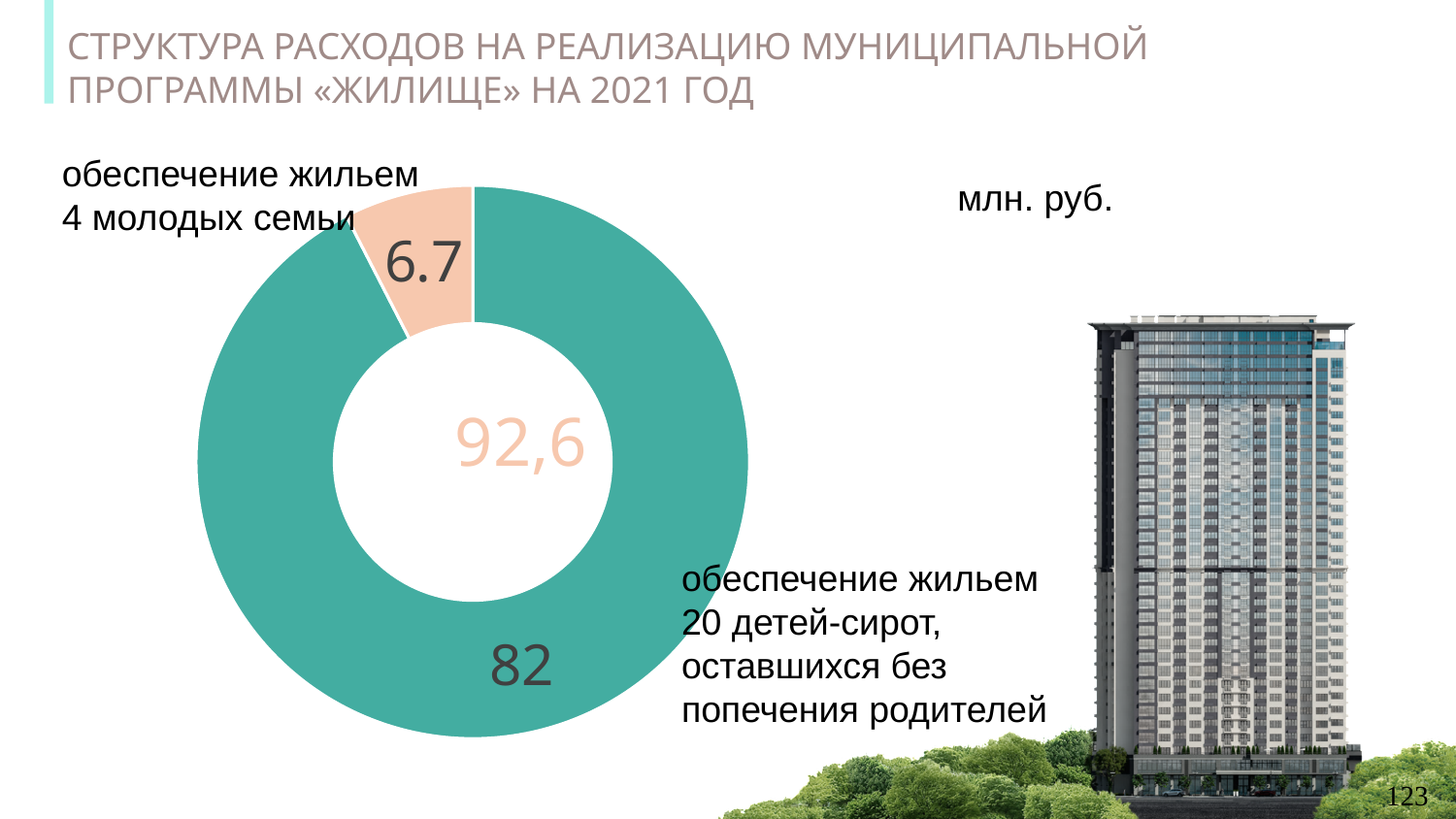
Which category has the smallest slice of the chart? обеспечение жильем 4 молодых семьи Which is larger: the value for housing for 20 orphans or the value for housing for 4 young families? housing for 20 orphans (82) How many slices does the chart have? 2 What value is shown for the slice labelled «обеспечение жильем 4 молодых семьи»? 6.7 What kind of chart is shown on the slide? pie (donut) chart Which category has the largest slice of the chart? обеспечение жильем 20 детей-сирот, оставшихся без попечения родителей What value is shown for the slice labelled «обеспечение жильем 20 детей-сирот, оставшихся без попечения родителей»? 82 What number is printed in the centre of the donut chart? 92,6 What is the difference between the value for housing for 20 orphans (82) and the value for housing for 4 young families (6.7)? 75.3 What unit of measurement is indicated for the chart values? млн. руб.